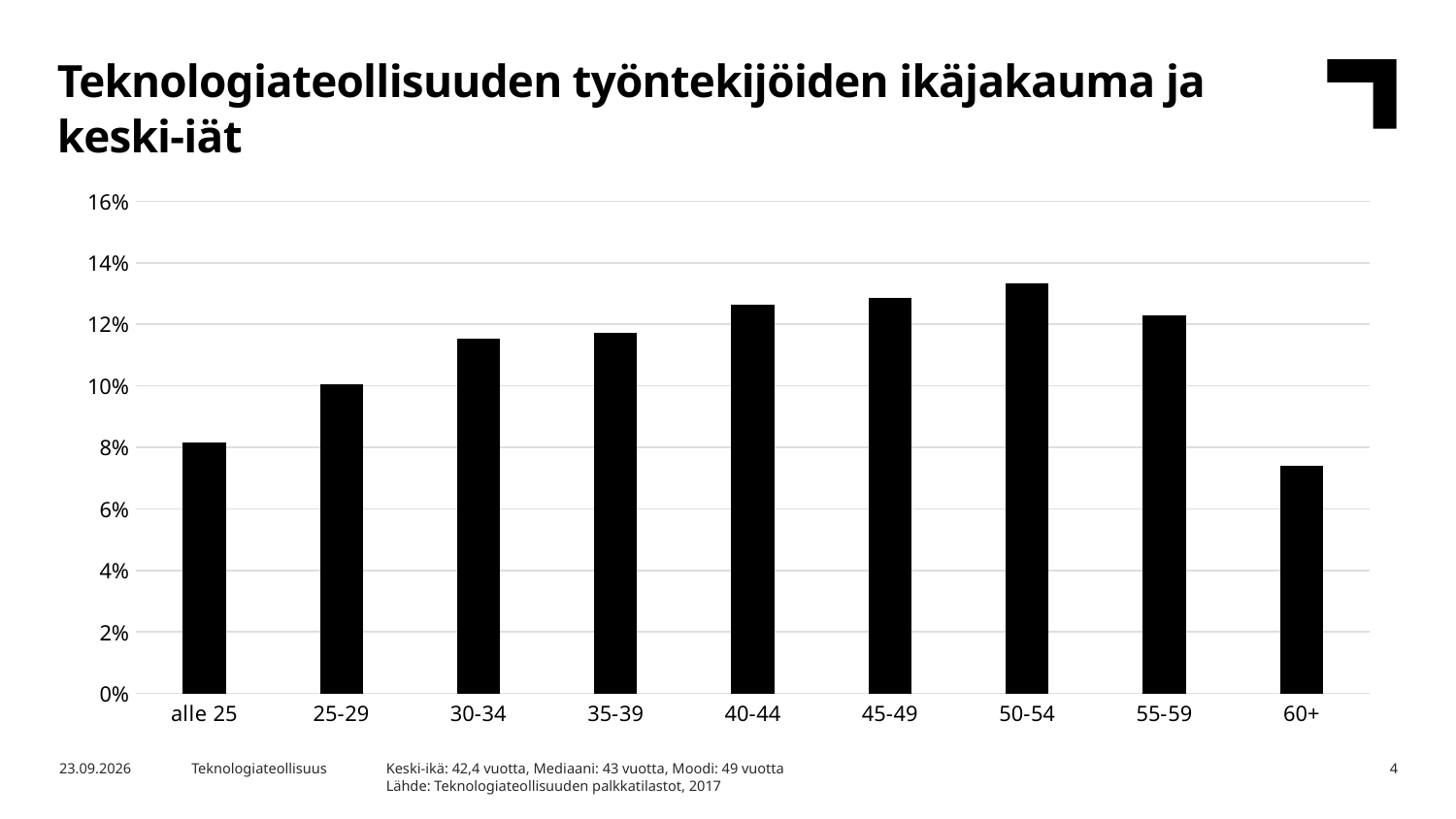
Is the value for 30-34 greater or less than 10%? greater Which age group has the lowest share? 60+ Is the value for 50-54 greater or less than 14%? less Do the values rise or fall from alle 25 to 50-54? rise What is the title of the chart? Teknologiateollisuuden työntekijöiden ikäjakauma ja keski-iät How many age groups are shown on the x axis? 9 Is the value for 60+ greater or less than 8%? less What kind of chart is shown on the slide? bar chart Which age group has the highest share? 50-54 Which is larger, the value for alle 25 or the value for 60+? alle 25